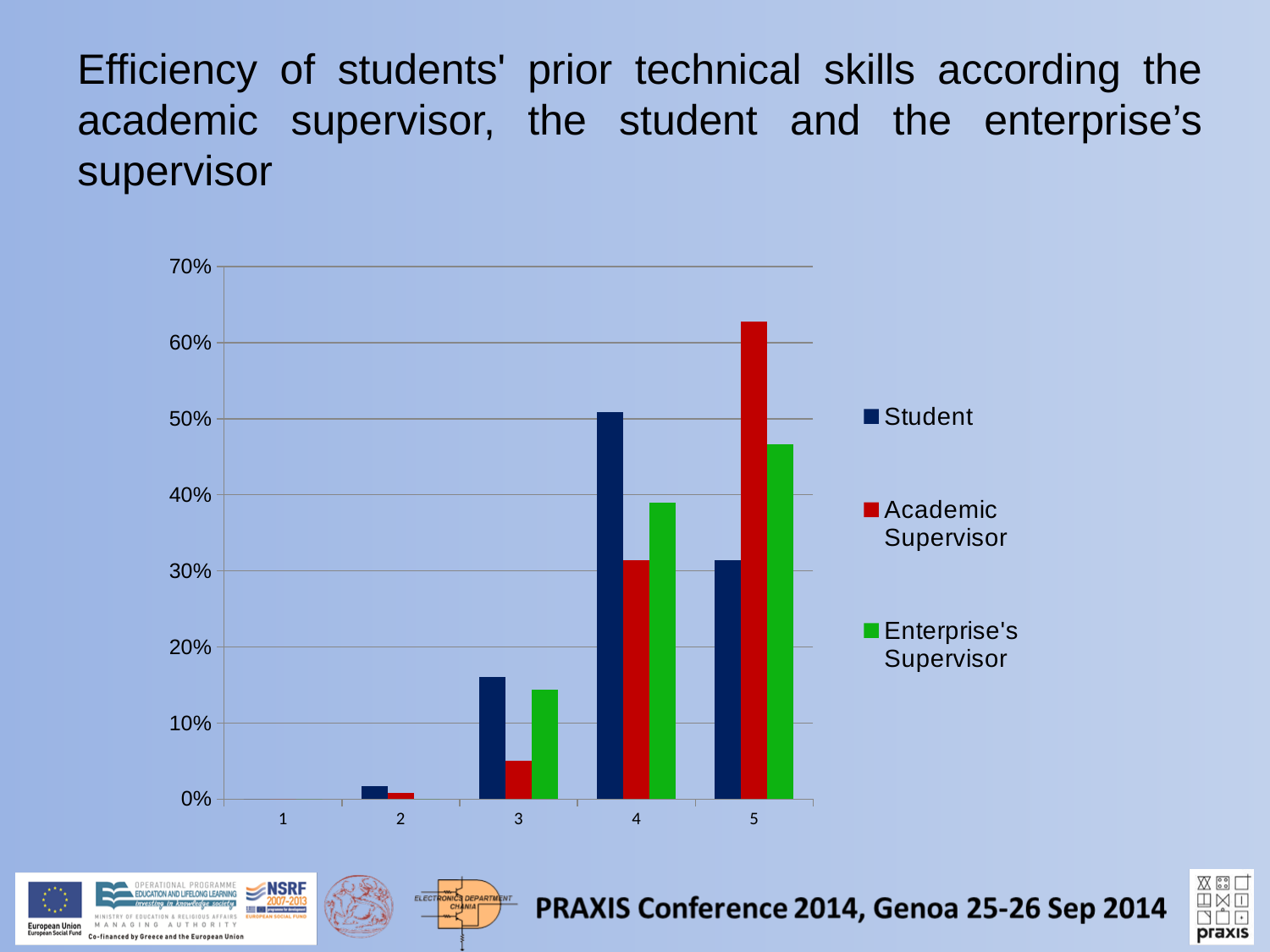
How many categories are shown on the x axis of the chart? 5 For which category is the Academic Supervisor series highest? 5 Is the Academic Supervisor value for category 5 greater or less than 60%? greater Which colour represents the Enterprise's Supervisor series in the chart? green How many series does the chart's legend list? 3 Is the Enterprise's Supervisor value for category 3 greater or less than 20%? less What kind of chart is shown on the slide? bar chart Which series has the tallest bar in the chart? Academic Supervisor For which category is the Student series highest? 4 For category 4, which is larger: the Student value or the Academic Supervisor value? Student For category 5, which is larger: the Enterprise's Supervisor value or the Student value? Enterprise's Supervisor